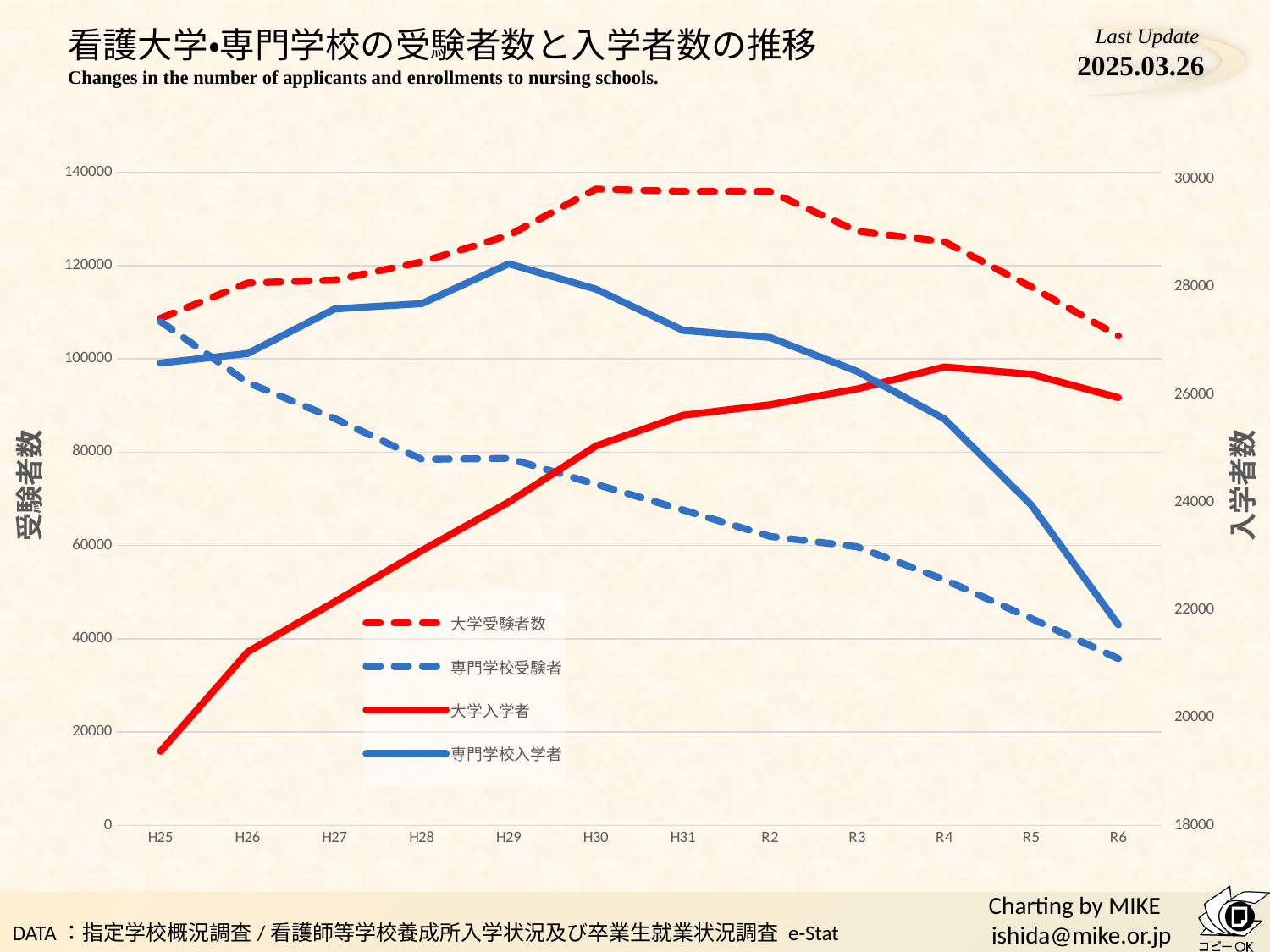
Does the 専門学校受験者 series rise or fall from H25 to R6? fall Is the value for 専門学校受験者 at R6 greater or less than 40000 on the left axis? less In which category is the 大学入学者 series at its lowest? H25 In which category is the 専門学校入学者 series at its lowest? R6 How many categories are shown along the x axis? 12 How many series does the legend list? 4 Is the value for 大学受験者数 at H30 greater or less than 120000 on the left axis? greater What is the label of the left vertical axis? 受験者数 Which category is the first on the x axis? H25 What kind of chart is shown on the slide? line chart At R6, which is larger: 大学受験者数 or 専門学校受験者? 大学受験者数 In which category is the 専門学校入学者 series at its highest? H29